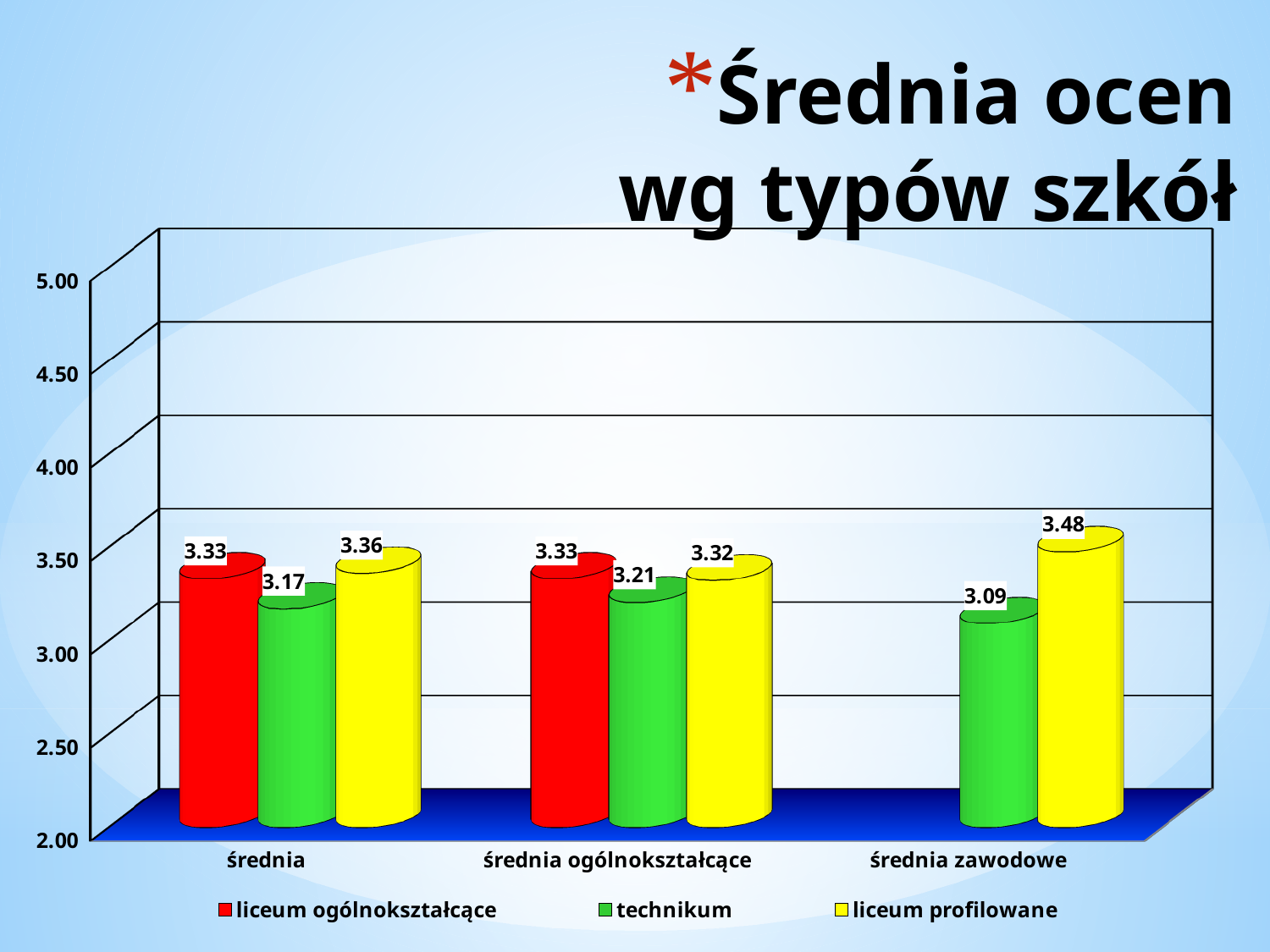
How many categories are shown on the x axis? 3 Which is larger in the średnia ogólnokształcące category: liceum ogólnokształcące or technikum? liceum ogólnokształcące Which series has the lowest value in the średnia category? technikum What is the value for liceum profilowane in the średnia zawodowe category? 3.48 What is the value for technikum in the średnia zawodowe category? 3.09 What kind of chart is shown on the slide? bar chart What is the value for liceum ogólnokształcące in the średnia ogólnokształcące category? 3.33 Which series has the highest value in the średnia zawodowe category? liceum profilowane What is the difference between liceum profilowane and technikum in the średnia zawodowe category? 0.39 How many series does the legend list? 3 Is the value for technikum in the średnia zawodowe category greater or less than 3.50? less What is the value for technikum in the średnia category? 3.17